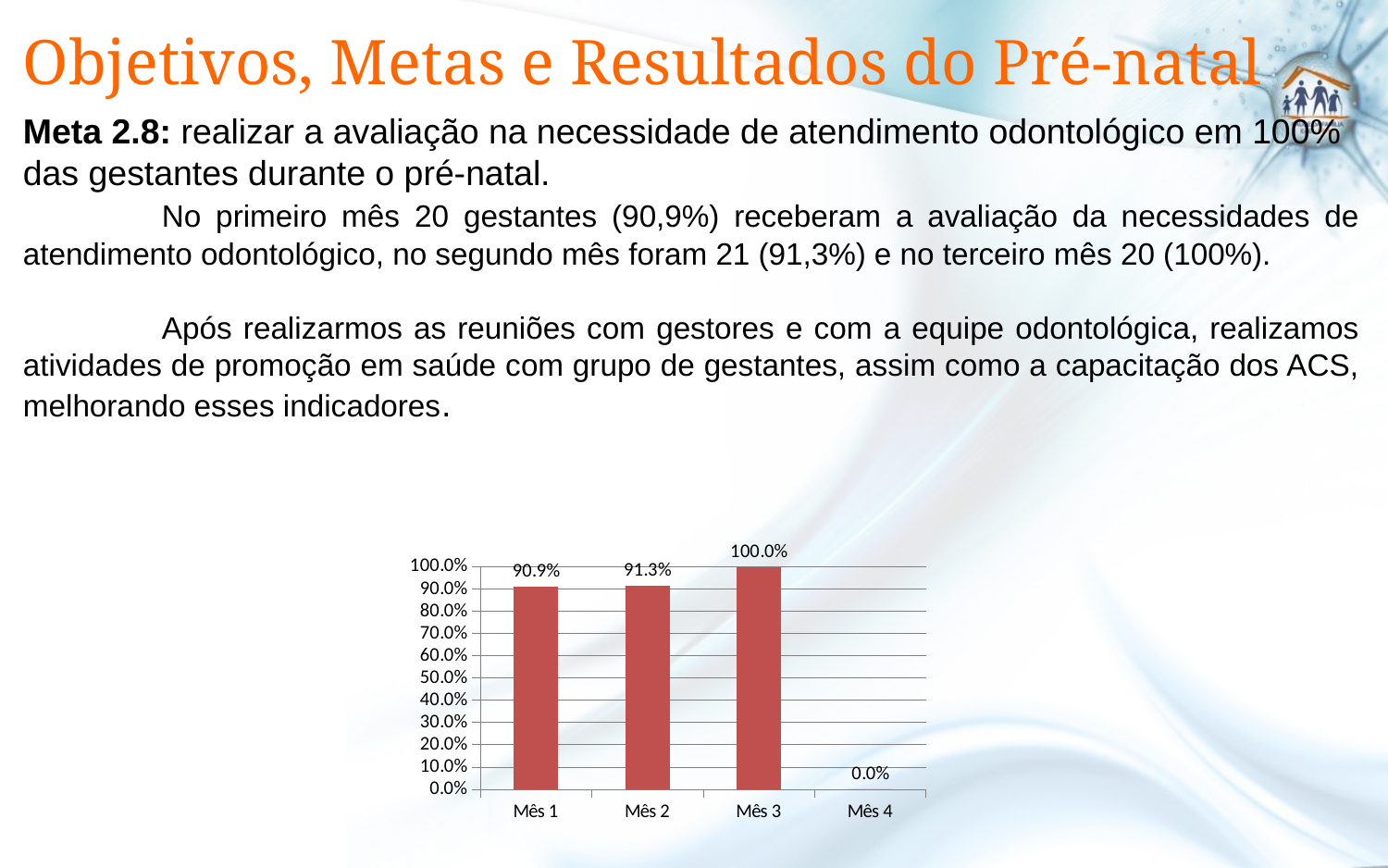
How many categories are shown on the x axis? 4 Is the value for Mês 2 greater or less than 80.0%? greater Which month has the highest value? Mês 3 What is the value for Mês 2? 91.3% Which is larger, the value for Mês 3 or the value for Mês 2? Mês 3 What is the value for Mês 4? 0.0% Which month has the lowest value? Mês 4 What kind of chart is shown on the slide? bar chart What is the value for Mês 1? 90.9% What is the difference between the values for Mês 3 and Mês 1? 9.1% What is the value for Mês 3? 100.0% What is the highest value shown on the y axis? 100.0%